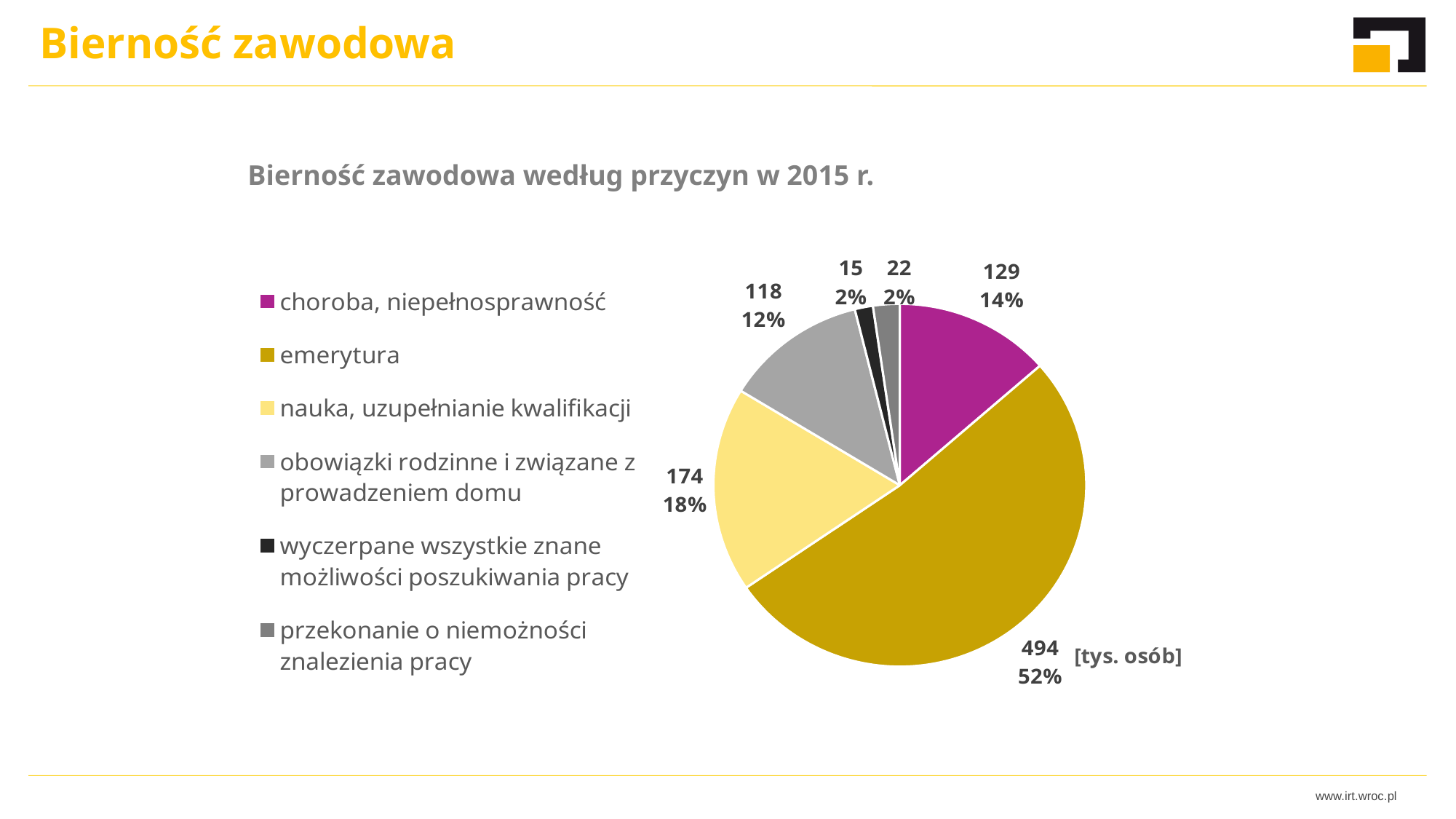
What share of the pie does nauka, uzupełnianie kwalifikacji represent? 18% What is the value for choroba, niepełnosprawność? 129 What share of the pie does emerytura represent? 52% What is the value for emerytura? 494 Which category has the smallest slice? wyczerpane wszystkie znane możliwości poszukiwania pracy How many categories does the legend list? 6 Which category has the largest slice? emerytura What is the value for obowiązki rodzinne i związane z prowadzeniem domu? 118 What kind of chart is shown on the slide? pie chart What is the value for nauka, uzupełnianie kwalifikacji? 174 What is the difference between the values for emerytura and nauka, uzupełnianie kwalifikacji? 320 Which is larger, the value for choroba, niepełnosprawność or the value for obowiązki rodzinne i związane z prowadzeniem domu? choroba, niepełnosprawność